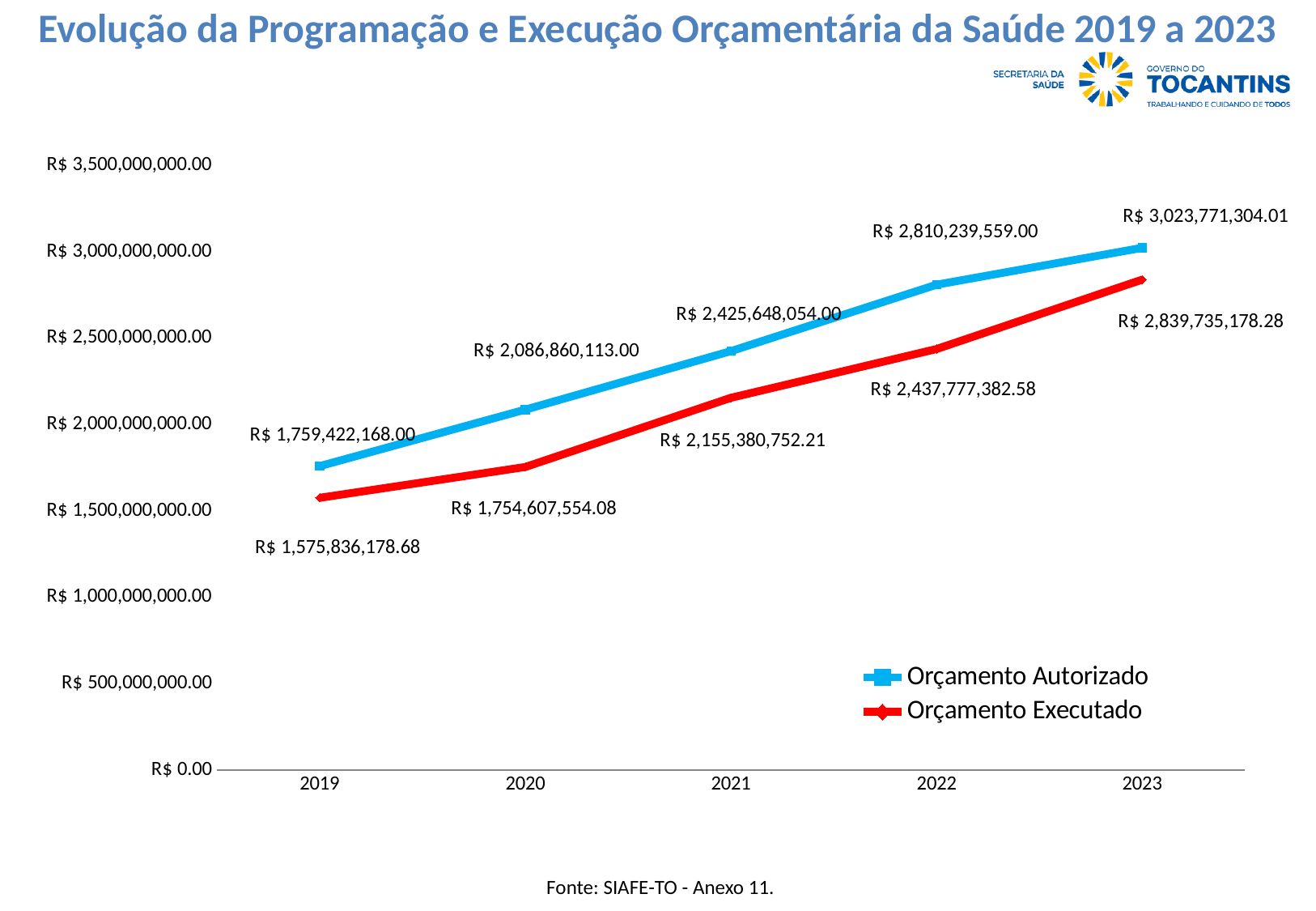
What is the value of Orçamento Autorizado in 2022? R$ 2,810,239,559.00 What is the difference between Orçamento Autorizado and Orçamento Executado in 2023? R$ 184,036,125.73 What type of chart is shown on the slide? Line chart Does Orçamento Executado rise or fall from 2019 to 2023? Rise What is the value of Orçamento Autorizado in 2019? R$ 1,759,422,168.00 In which year is Orçamento Autorizado highest? 2023 In which year is Orçamento Executado lowest? 2019 What is the value of Orçamento Executado in 2021? R$ 2,155,380,752.21 How many series does the legend list? 2 Which is larger in 2020, Orçamento Autorizado or Orçamento Executado? Orçamento Autorizado How many years are plotted along the x axis? 5 What is the value of Orçamento Executado in 2023? R$ 2,839,735,178.28